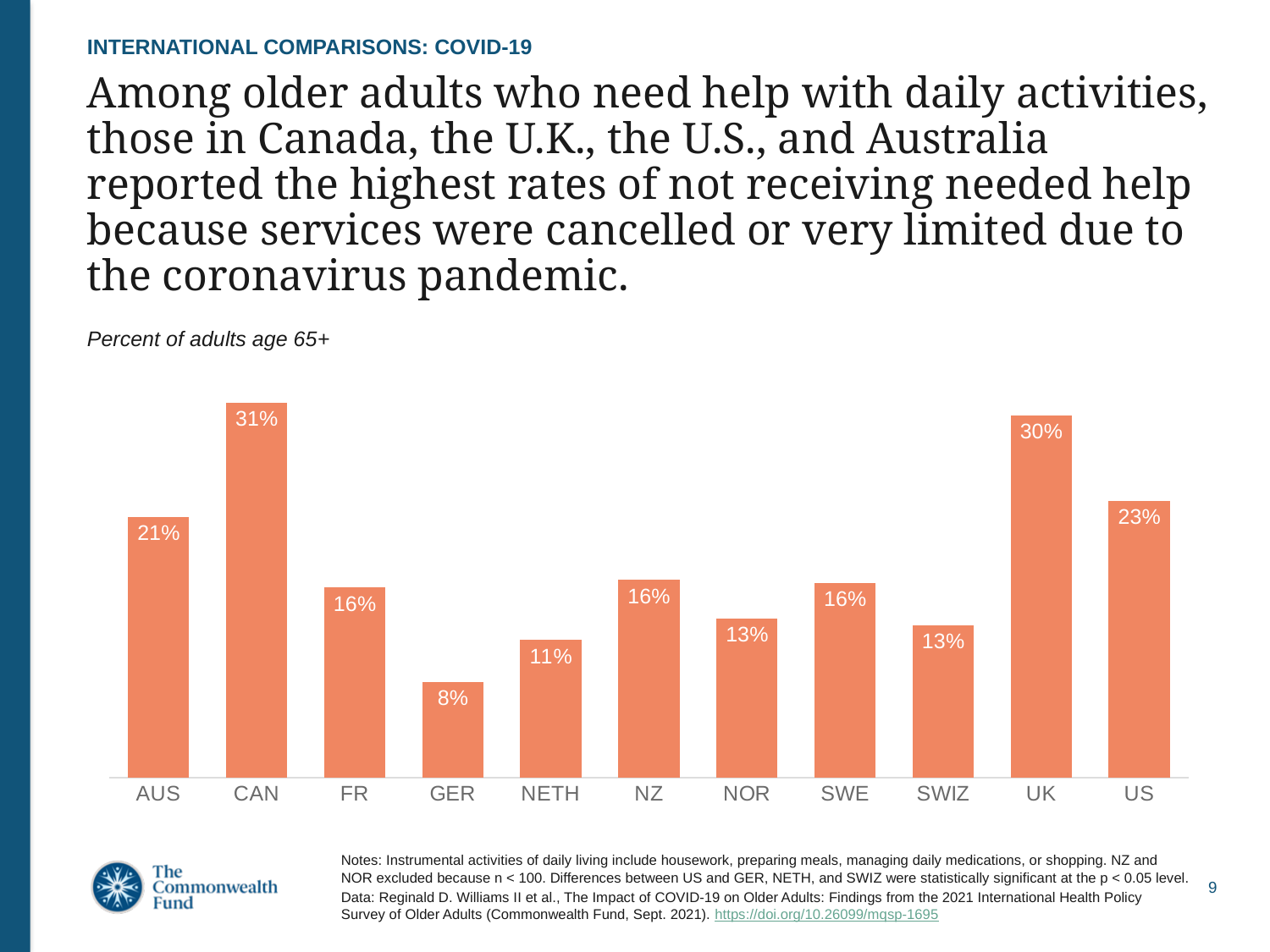
What is the value for CAN? 31% What is the value for NETH? 11% Which is larger, the value for UK or the value for US? UK What is the value for US? 23% What is the difference between the values for AUS and GER? 13% How many countries are shown on the chart? 11 What is the subtitle shown above the chart? Percent of adults age 65+ Which country has the highest value? CAN What kind of chart is shown on the slide? Bar chart What is the difference between the values for CAN and UK? 1% Which country has the lowest value? GER What is the value for GER? 8%